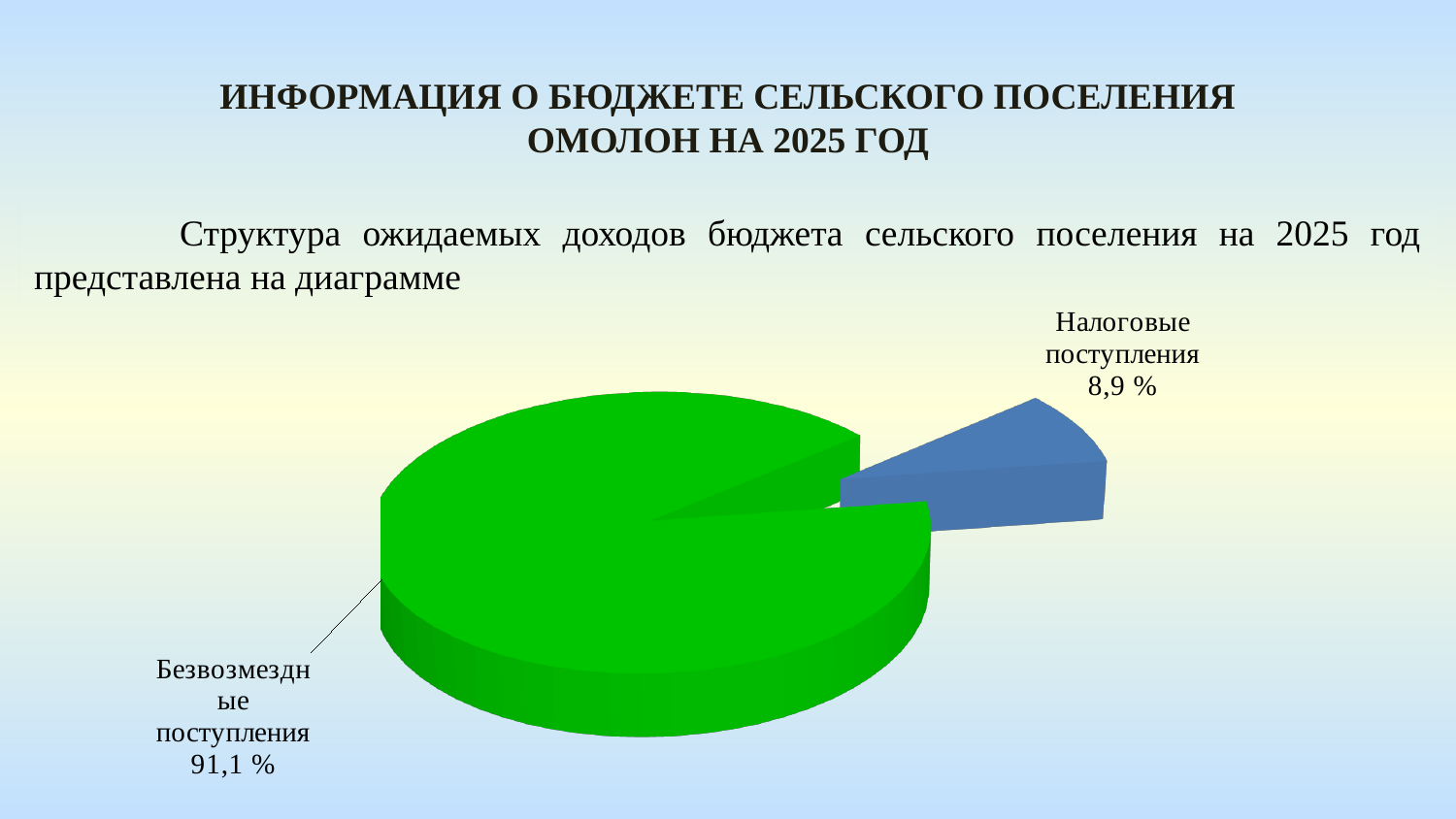
How many slices does the pie chart have? 2 Which is larger: Налоговые поступления or Безвозмездные поступления? Безвозмездные поступления What colour is the slice for Налоговые поступления? Blue Which slice of the pie is the largest? Безвозмездные поступления What is the total of the two labelled shares in the pie chart? 100 % What colour is the slice for Безвозмездные поступления? Green What is the difference in percentage points between Безвозмездные поступления and Налоговые поступления? 82,2 What kind of chart is shown on the slide? Pie chart What share of the pie is labelled for Безвозмездные поступления? 91,1 % What share of the pie is labelled for Налоговые поступления? 8,9 % Which slice of the pie is the smallest? Налоговые поступления